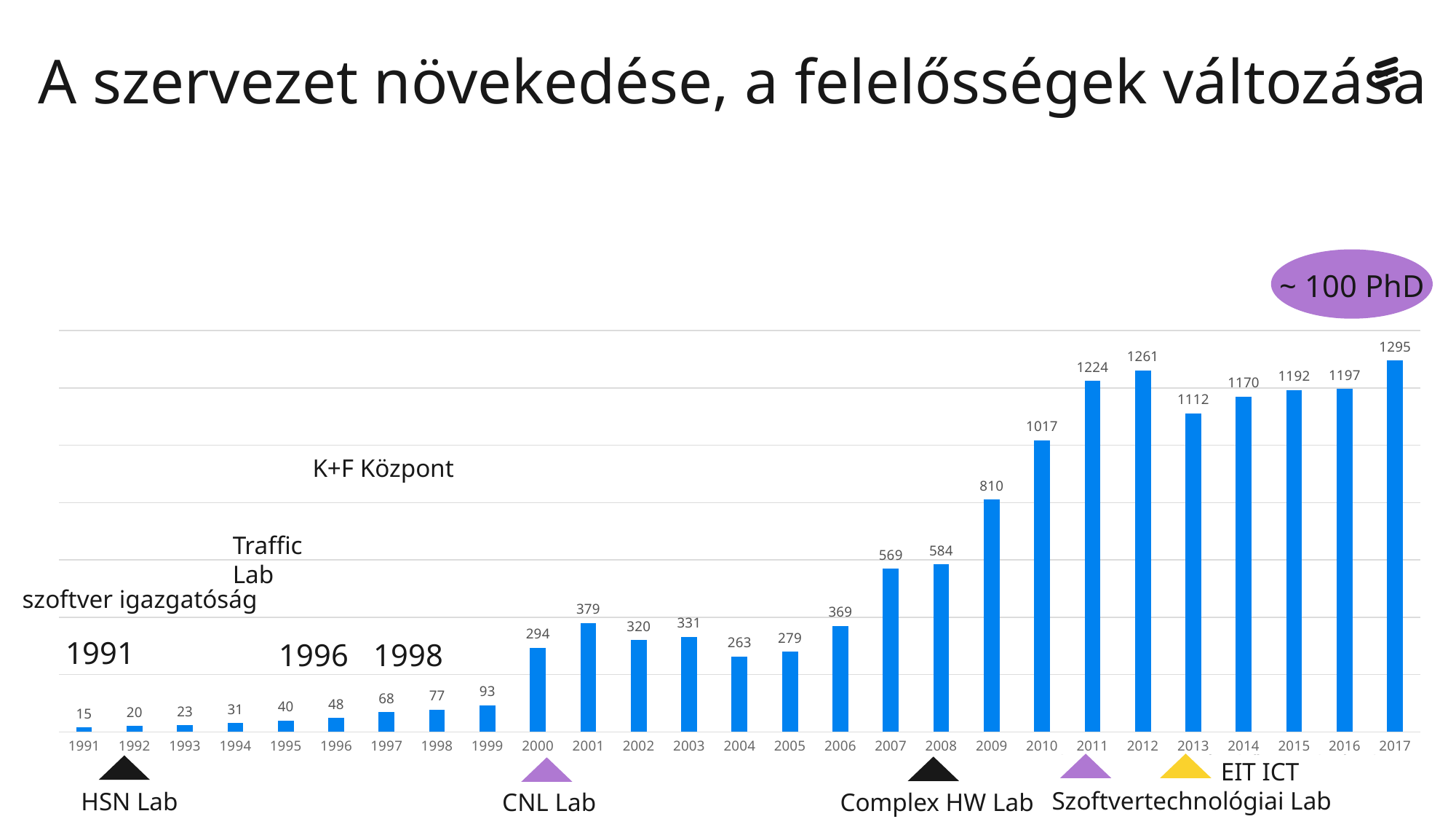
Which year has the highest value? 2017 What is the difference between the values for 2012 and 2011? 37 Do the values generally rise or fall from 1991 to 2017? Rise What is the value shown for 2010? 1017 Which year has the larger value, 2013 or 2014? 2014 Which year has the lowest value? 1991 What is the value shown for 2000? 294 What is the value shown for 1999? 93 Which year has the larger value, 2001 or 2002? 2001 What kind of chart is shown on the slide? Bar chart How many years are shown on the x axis? 27 What is the difference between the values for 2017 and 2016? 98